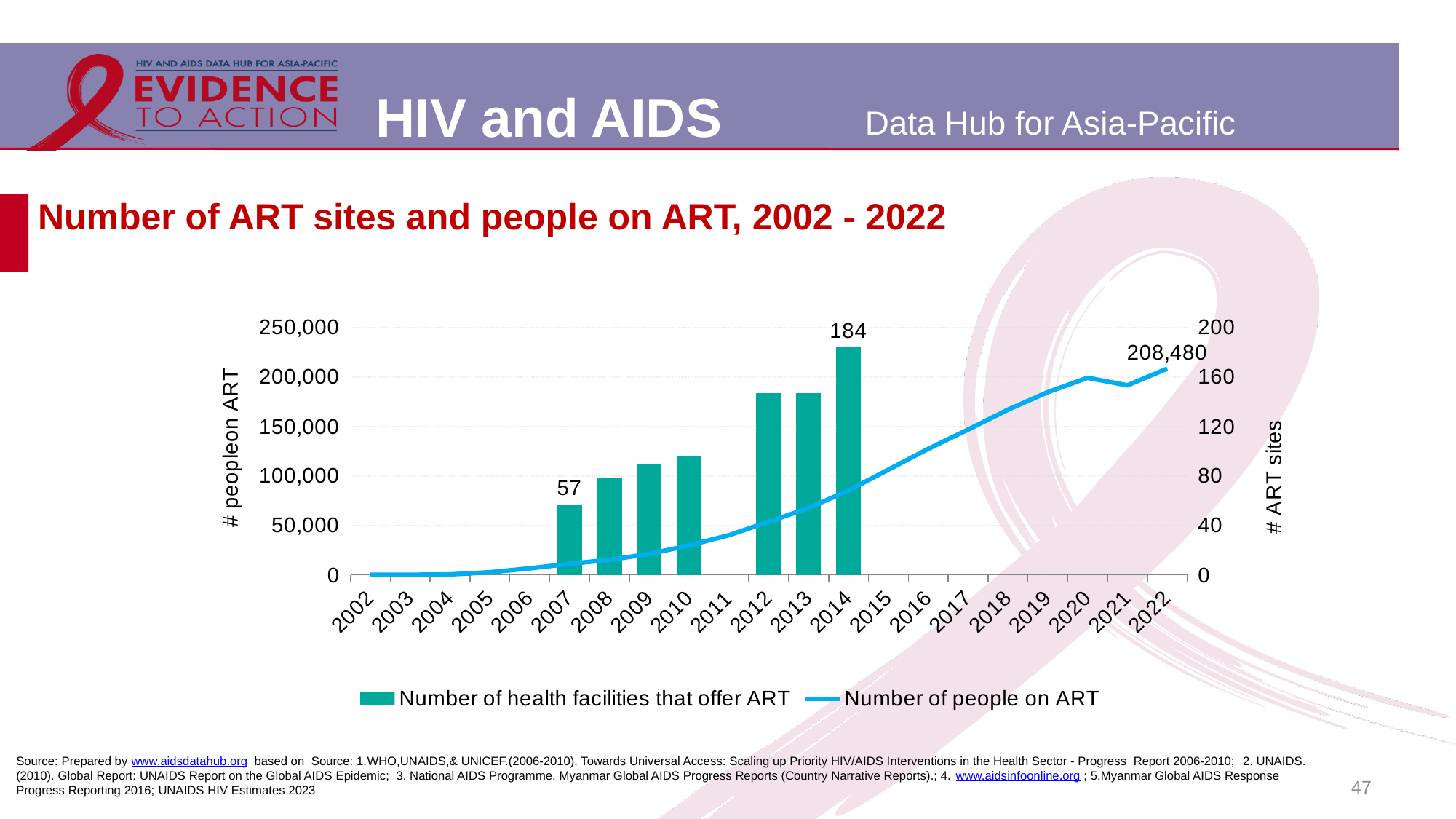
What is the difference between the number of health facilities that offer ART in 2014 and in 2007? 127 How many series does the legend list? 2 What kind of chart is shown on the slide? Combination bar and line chart What is the number of health facilities that offer ART in 2014? 184 What is the number of health facilities that offer ART in 2007? 57 Is the number of people on ART in 2010 greater or less than 50,000? less What is the number of people on ART in 2022? 208,480 Is the number of health facilities that offer ART in 2010 greater or less than 80? greater Does the number of people on ART generally rise or fall from 2002 to 2022? Rise Is the number of people on ART in 2018 greater or less than 150,000? greater In which year is the number of health facilities that offer ART highest? 2014 Among the years with a bar shown, which year has the lowest number of health facilities that offer ART? 2007